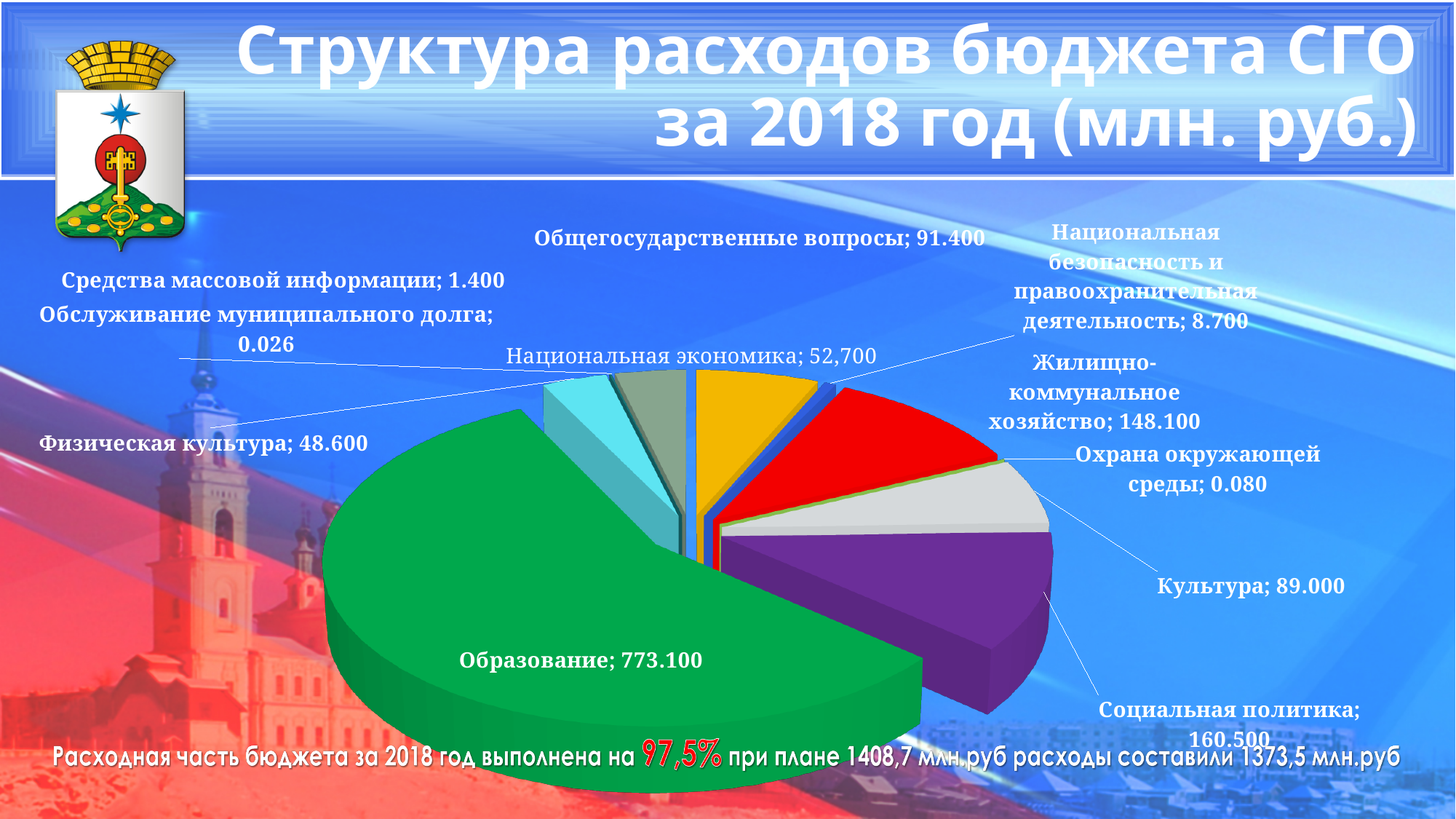
Which is larger: Общегосударственные вопросы or Культура? Общегосударственные вопросы What is the value for Национальная экономика? 52,700 What is the value for Охрана окружающей среды? 0.080 What is the value for Жилищно-коммунальное хозяйство? 148.100 Which category has the smallest value in the pie chart? Обслуживание муниципального долга How many categories are shown in the pie chart? 11 What is the value for Социальная политика? 160.500 What is the value for Образование? 773.100 Which category has the largest value in the pie chart? Образование What is the difference between Социальная политика and Жилищно-коммунальное хозяйство? 12.400 What colour is the Образование slice? Green What type of chart is shown on the slide? Pie chart